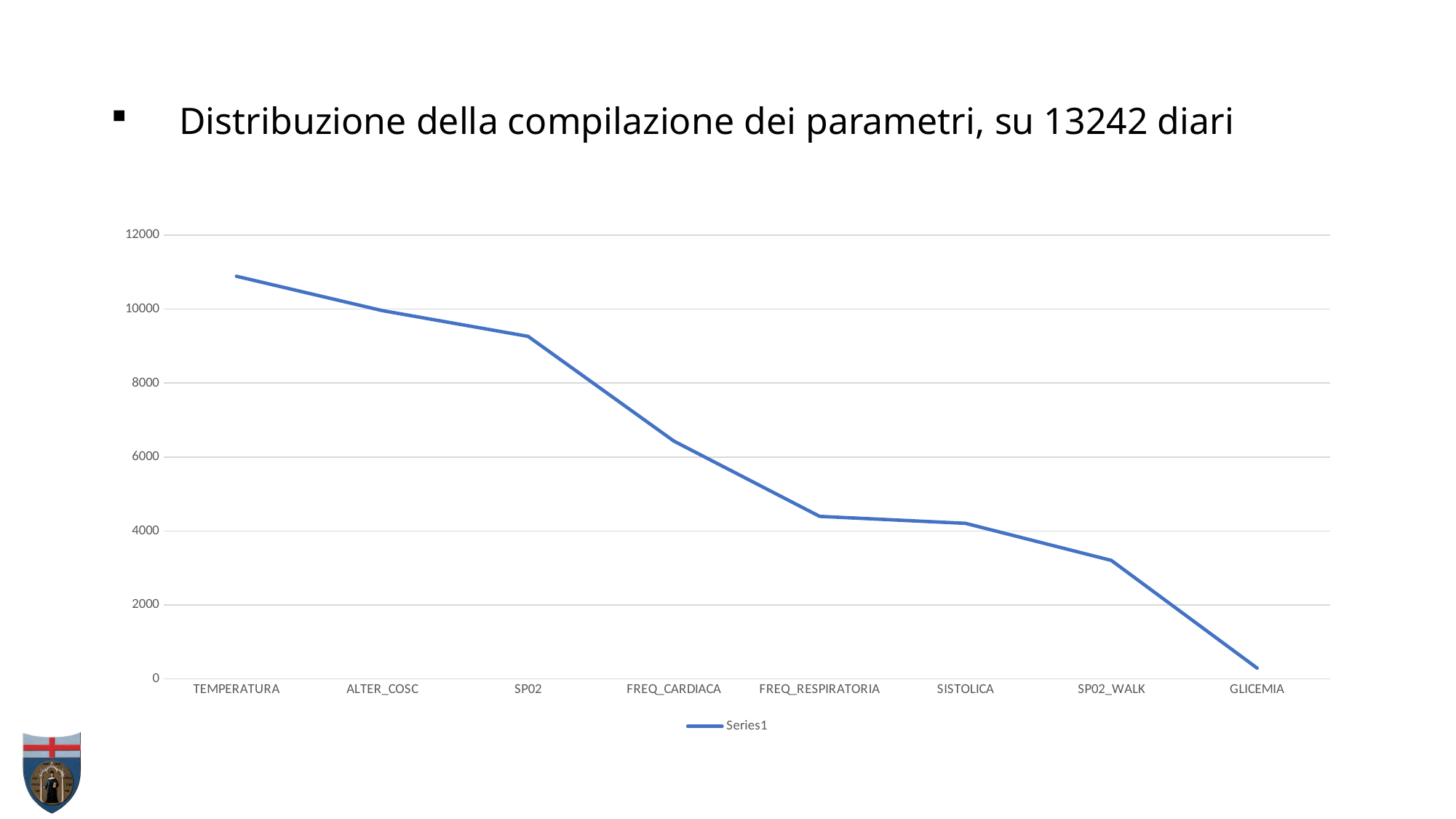
What kind of chart is shown on the slide? line chart Is the value for TEMPERATURA greater or less than 10000? greater Is the value for SP02_WALK greater or less than 2000? greater Which category has the lowest value? GLICEMIA Which category has the highest value? TEMPERATURA What is the name of the series shown in the legend? Series1 Do the values rise or fall from left to right along the x axis? fall How many series does the legend list? 1 Is the value for FREQ_CARDIACA greater or less than 8000? less How many categories are plotted along the x axis? 8 Which has a larger value, SP02 or FREQ_CARDIACA? SP02